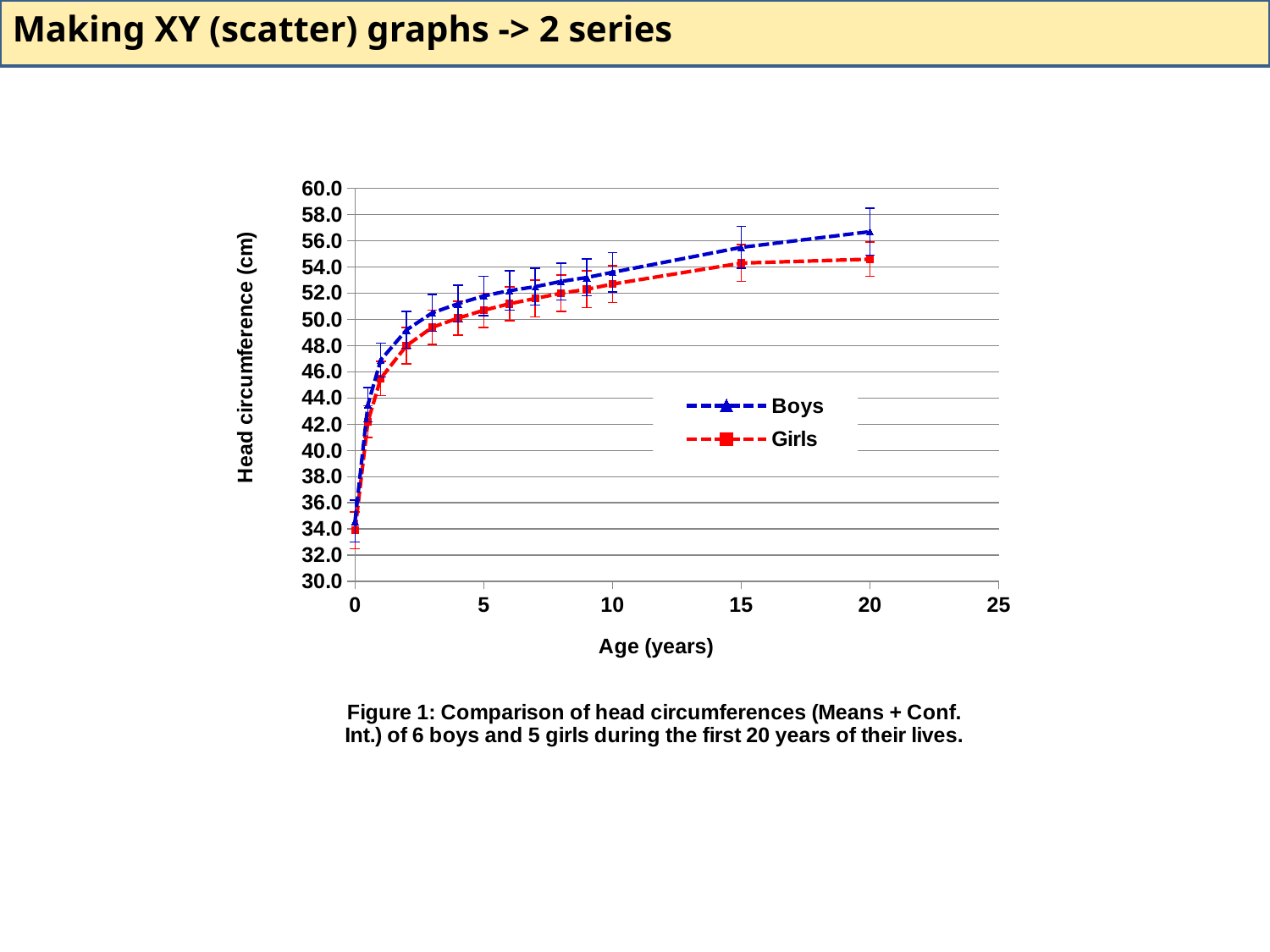
What are the two series named in the legend? Boys and Girls Do the head circumference values for Boys rise or fall as age increases? Rise At which age is the Girls head circumference lowest? 0 Is the value for Girls at age 10 greater or less than 50.0? greater Is the value for Boys at age 20 greater or less than 54.0? greater Is the value for Girls at age 0 greater or less than 36.0? less What kind of chart is shown on the slide? XY scatter chart with lines At age 20, which series has the larger head circumference, Boys or Girls? Boys How many series does the legend list? 2 At which age is the Boys head circumference highest? 20 What is the title of the vertical axis? Head circumference (cm)